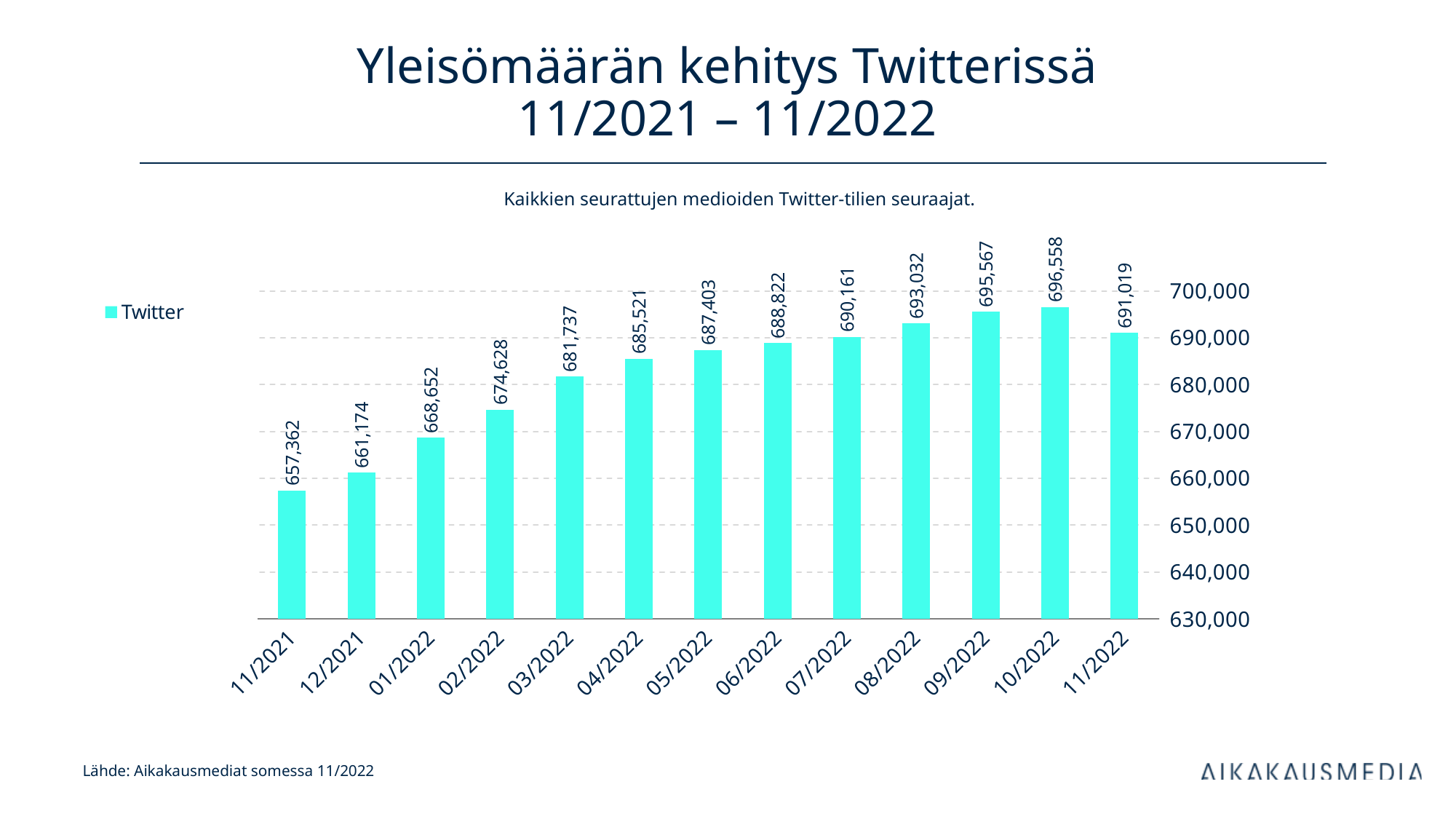
How many months are shown on the x axis? 13 What is the difference between the values for 10/2022 and 11/2022? 5,539 What series name does the legend show? Twitter Which is larger, the value for 03/2022 or the value for 08/2022? 08/2022 What is the value for 11/2021? 657,362 Is the value for 02/2022 greater or less than 680,000? less What is the value for 11/2022? 691,019 What is the difference between the values for 11/2022 and 11/2021? 33,657 What is the value for 05/2022? 687,403 Which month has the lowest value? 11/2021 What kind of chart is shown? bar chart Which month has the highest value? 10/2022